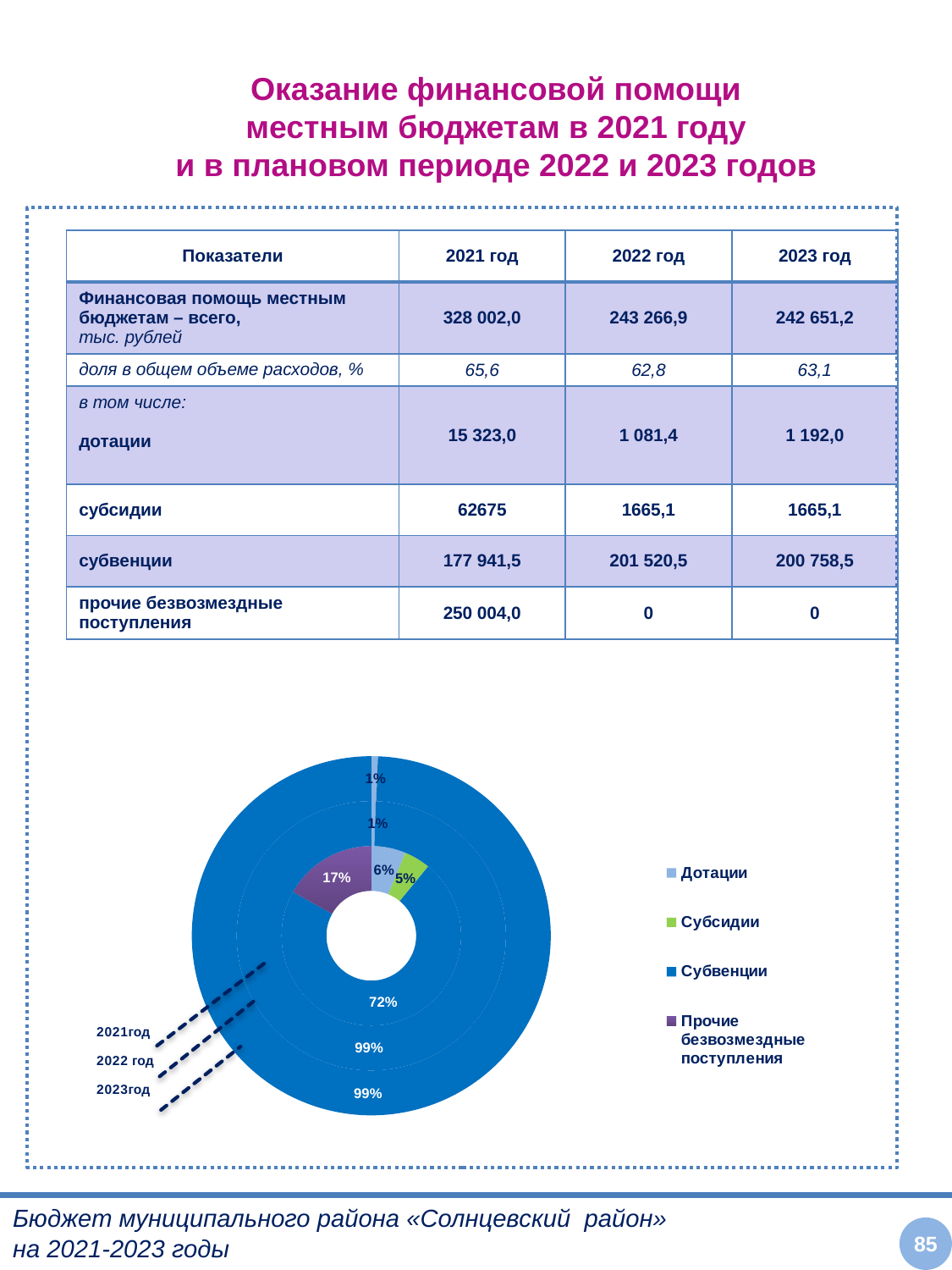
In the chart, which legend entry is shown in green? Субсидии How many series does the chart legend list? 4 In the chart, what is the difference between the Субвенции share and the Прочие безвозмездные поступления share in the 2021 ring? 55% In the chart, what share does Дотации have in the 2023 ring? 1% In the chart, what share does Прочие безвозмездные поступления have in the 2021 ring? 17% In the chart, what share does Дотации have in the 2021 ring? 6% In the chart, which category has the smallest share in the 2021 ring? Субсидии In the chart, what share does Субвенции have in the 2021 ring? 72% In the chart, what share does Субсидии have in the 2021 ring? 5% In the chart, which category has the largest share in the 2021 ring? Субвенции In the chart, what share does Субвенции have in the 2022 ring? 99% What kind of chart is shown on the slide? Doughnut chart